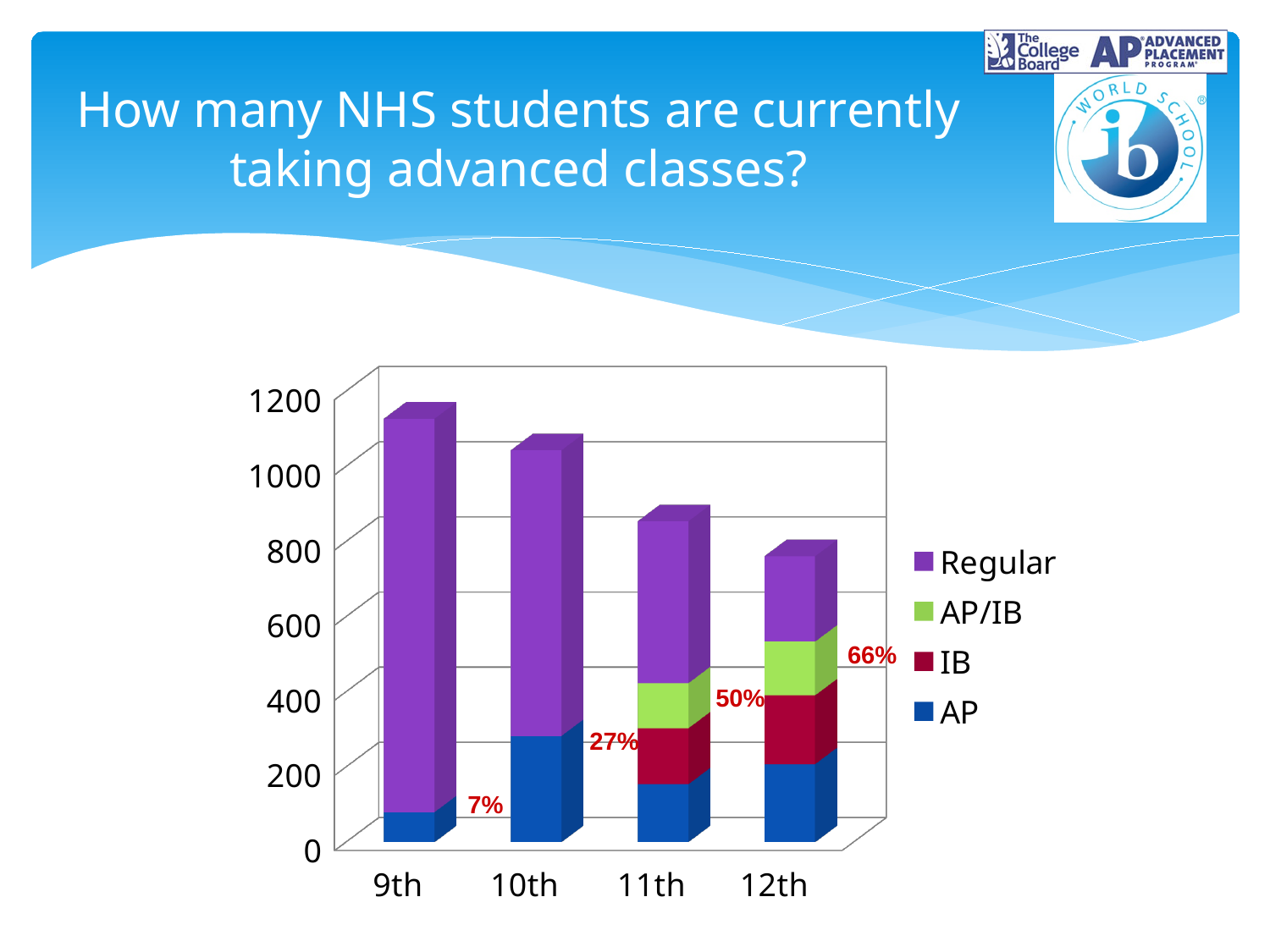
Is the total bar for 12th grade greater or less than 1000? less Do the total bar heights rise or fall from 9th to 12th grade? fall What percentage label is printed next to the 11th grade bar? 50% Which is larger, the total bar for 9th grade or for 12th grade? 9th What kind of chart is shown on the slide? stacked bar chart Which grade has the tallest total bar? 9th How many series does the legend list? 4 Is the total bar for 9th grade greater or less than 1000? greater How many grade categories are shown on the x axis? 4 What percentage label is printed next to the 12th grade bar? 66% Which grade has the shortest total bar? 12th Is the total bar for 10th grade greater or less than 800? greater